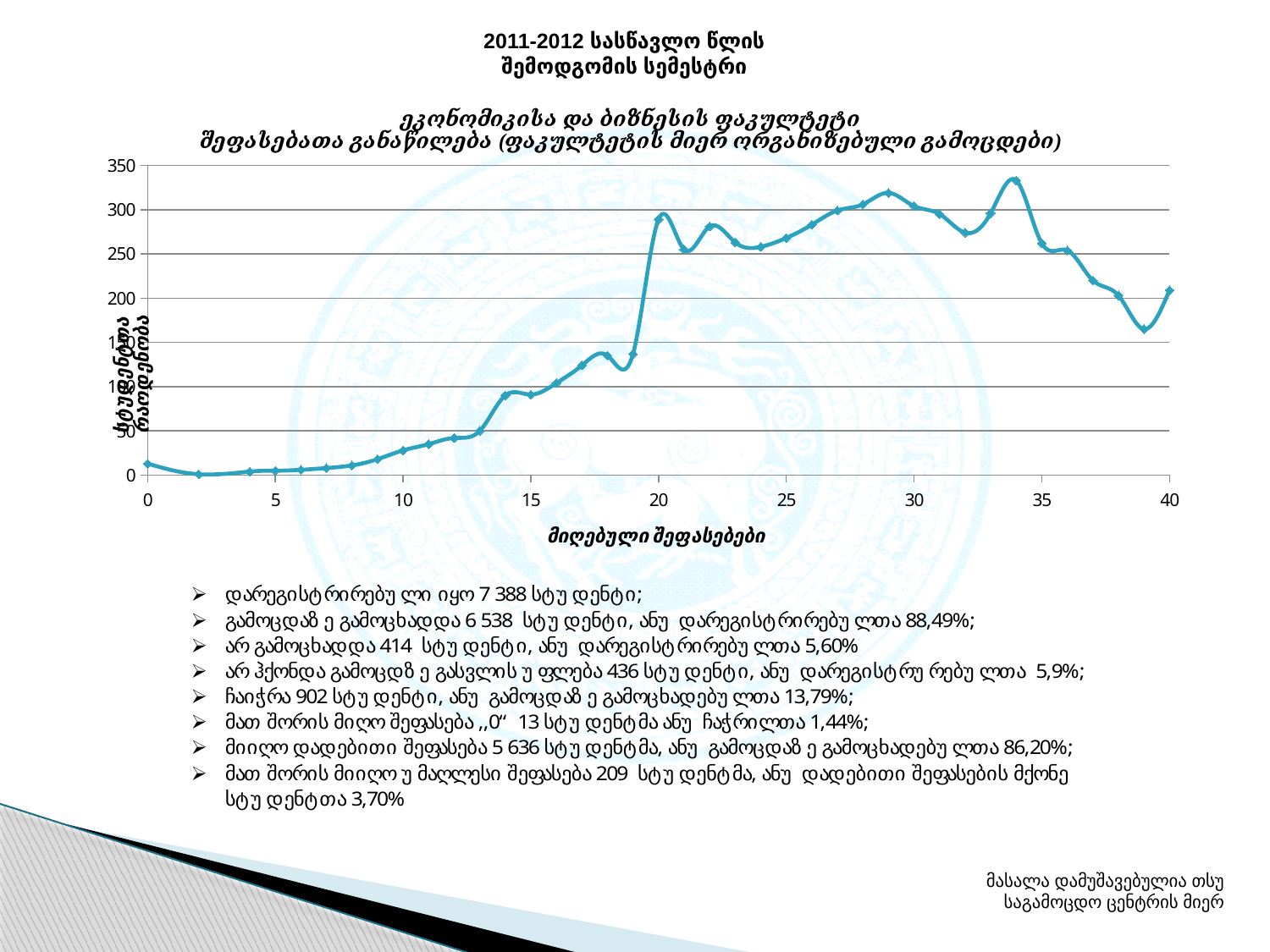
Do the values rise or fall along the x axis between x = 0 and x = 20? rise Is the value at x = 39 greater or less than 200? less Do the values rise or fall along the x axis between x = 34 and x = 39? fall Is the value at x = 34 greater or less than 300? greater Is the value at x = 5 greater or less than 50? less What is the highest value shown on the y axis of the chart? 350 What kind of chart is shown on the slide? line chart Which is larger, the value at x = 20 or the value at x = 10? x = 20 What is the title of the x axis of the chart? მიღებული შეფასებები